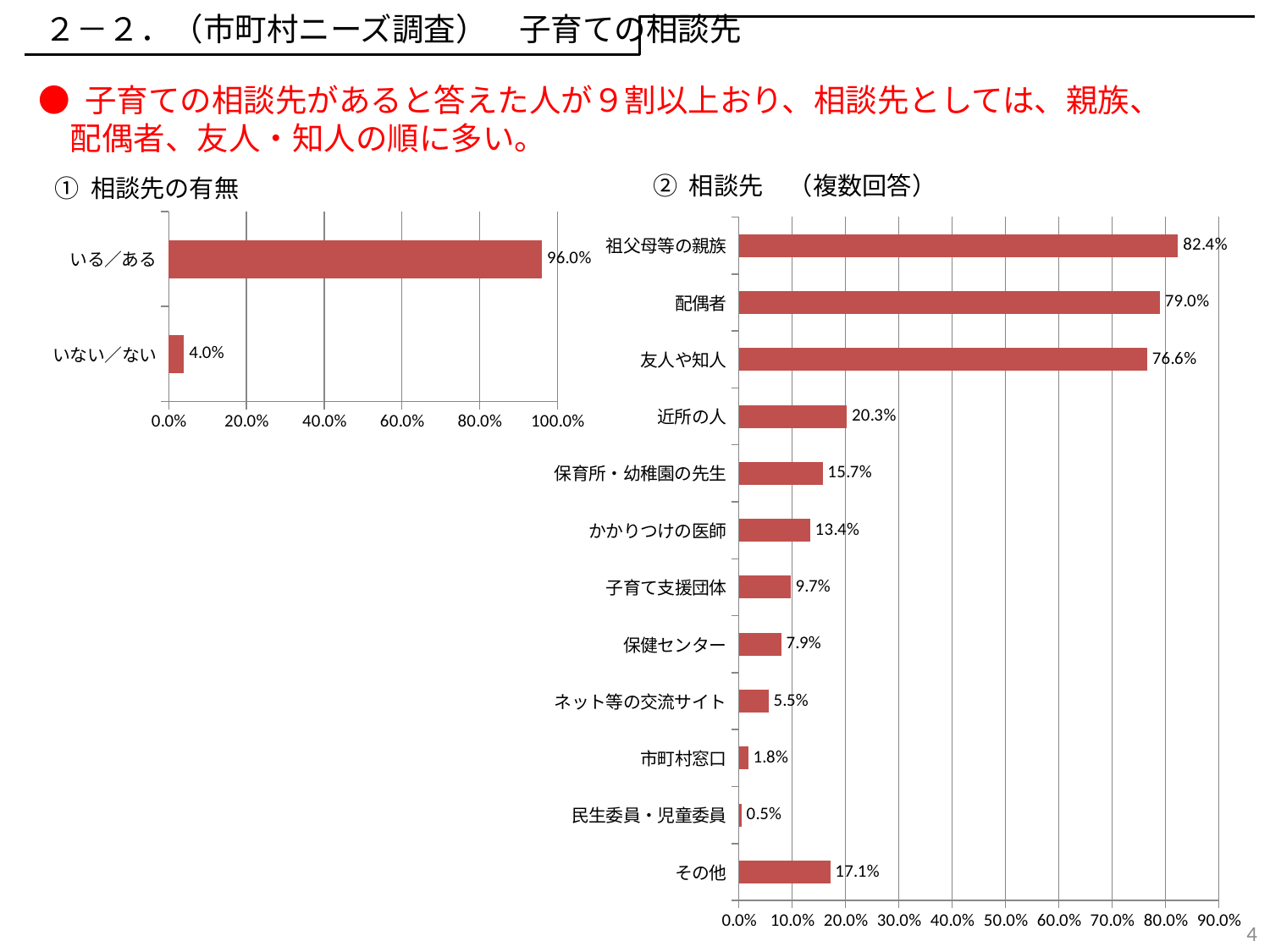
In the chart titled ② 相談先 （複数回答）, which category has the lowest value? 民生委員・児童委員 What kind of chart is the chart titled ② 相談先 （複数回答）? Bar chart In the chart titled ② 相談先 （複数回答）, what is the value for 近所の人? 20.3% In the chart titled ② 相談先 （複数回答）, how many categories are shown? 12 In the chart titled ① 相談先の有無, what is the value for いない／ない? 4.0% In the chart titled ① 相談先の有無, what is the difference between いる／ある and いない／ない? 92.0% In the chart titled ② 相談先 （複数回答）, what is the difference between 祖父母等の親族 and 友人や知人? 5.8% In the chart titled ② 相談先 （複数回答）, which category has the highest value? 祖父母等の親族 In the chart titled ② 相談先 （複数回答）, what is the value for 配偶者? 79.0% In the chart titled ② 相談先 （複数回答）, is the value for 子育て支援団体 greater or less than 10.0%? less In the chart titled ① 相談先の有無, what is the value for いる／ある? 96.0% In the chart titled ② 相談先 （複数回答）, which is larger, 保育所・幼稚園の先生 or その他? その他